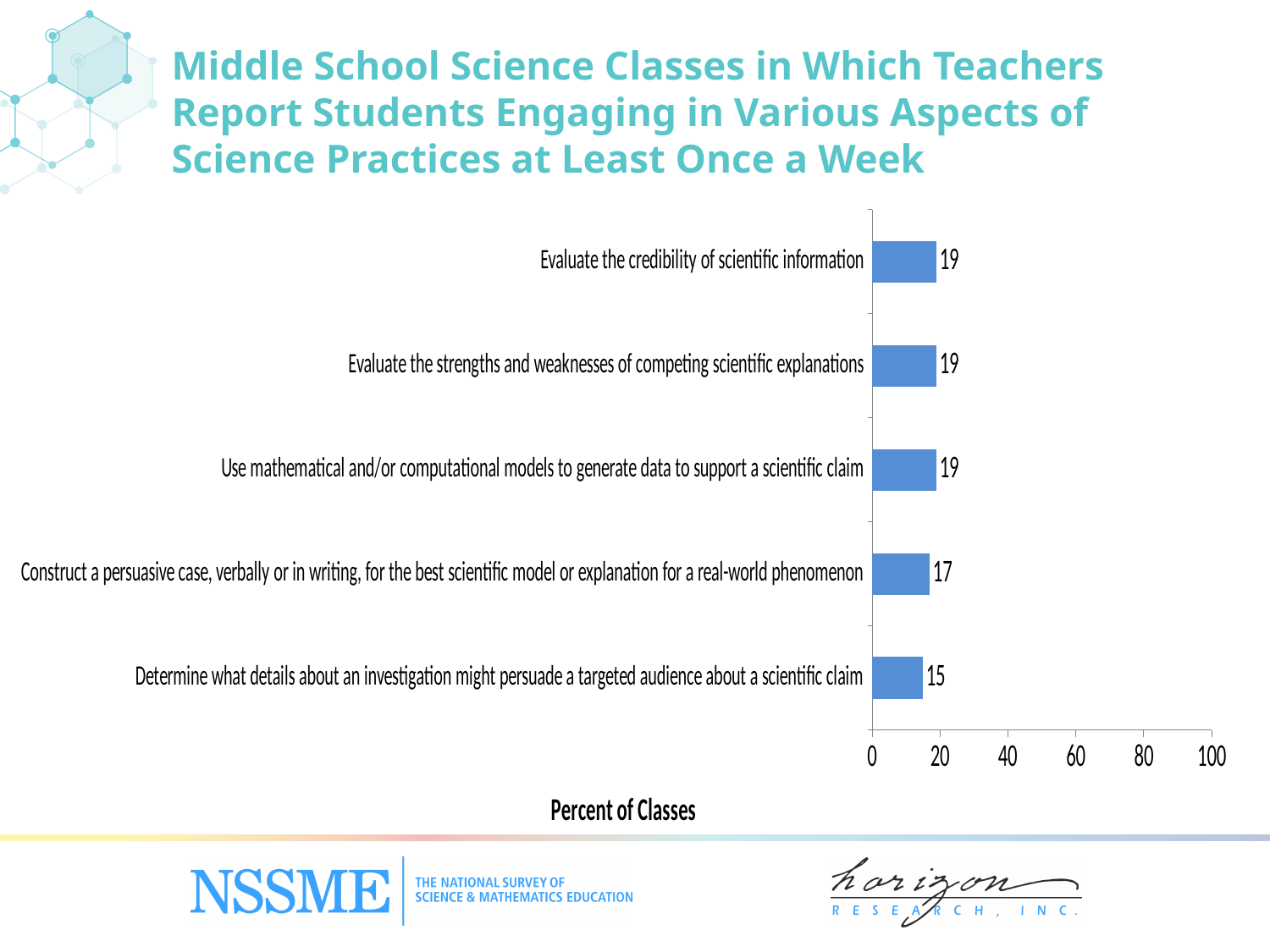
What is the label of the horizontal axis? Percent of Classes What is the value for "Construct a persuasive case, verbally or in writing, for the best scientific model or explanation for a real-world phenomenon"? 17 How many categories are shown in the chart? 5 Is the value for "Evaluate the credibility of scientific information" greater or less than 40? less What is the difference between the values for "Evaluate the strengths and weaknesses of competing scientific explanations" and "Construct a persuasive case, verbally or in writing, for the best scientific model or explanation for a real-world phenomenon"? 2 Which category has the lowest percent of classes? Determine what details about an investigation might persuade a targeted audience about a scientific claim What kind of chart is shown on the slide? bar chart Which is larger: the value for "Construct a persuasive case, verbally or in writing, for the best scientific model or explanation for a real-world phenomenon" or the value for "Determine what details about an investigation might persuade a targeted audience about a scientific claim"? Construct a persuasive case, verbally or in writing, for the best scientific model or explanation for a real-world phenomenon What is the value for "Use mathematical and/or computational models to generate data to support a scientific claim"? 19 What is the value for "Determine what details about an investigation might persuade a targeted audience about a scientific claim"? 15 What percent of classes is reported for "Evaluate the credibility of scientific information"? 19 What is the difference between the value for "Evaluate the credibility of scientific information" and the value for "Determine what details about an investigation might persuade a targeted audience about a scientific claim"? 4